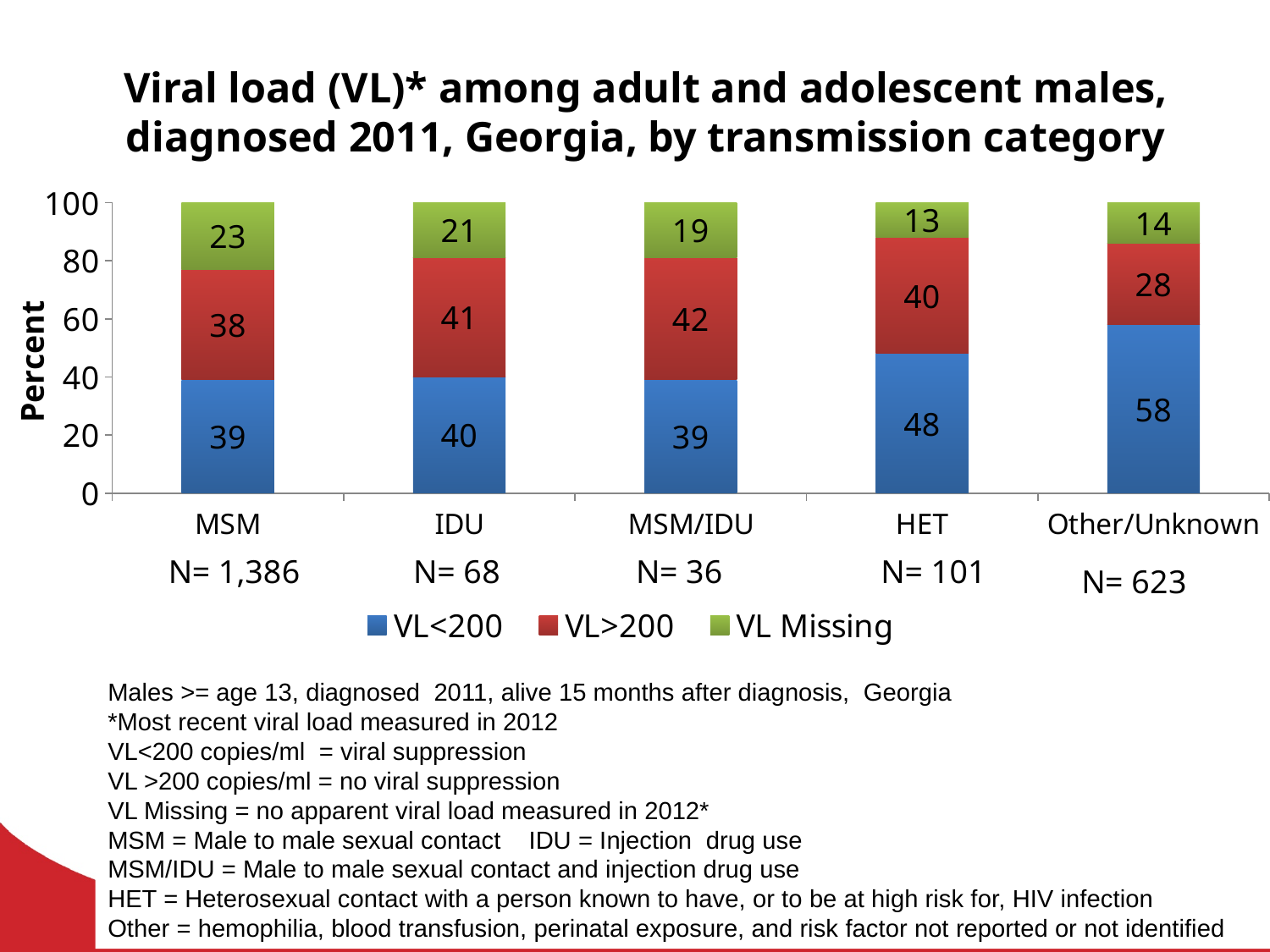
What is the VL>200 value for MSM/IDU? 42 Which transmission category has the lowest VL Missing value? HET Which is larger, the VL>200 value for IDU or for Other/Unknown? IDU What is the VL<200 value for HET? 48 How many transmission categories are shown on the x axis? 5 What is the total of the stacked bar for IDU? 102 Which transmission category has the highest VL<200 value? Other/Unknown What is the difference between the VL<200 values for Other/Unknown and MSM? 19 What is the VL Missing value for MSM? 23 What kind of chart is shown on the slide? Stacked bar chart What is the label of the y axis? Percent How many series does the legend list? 3